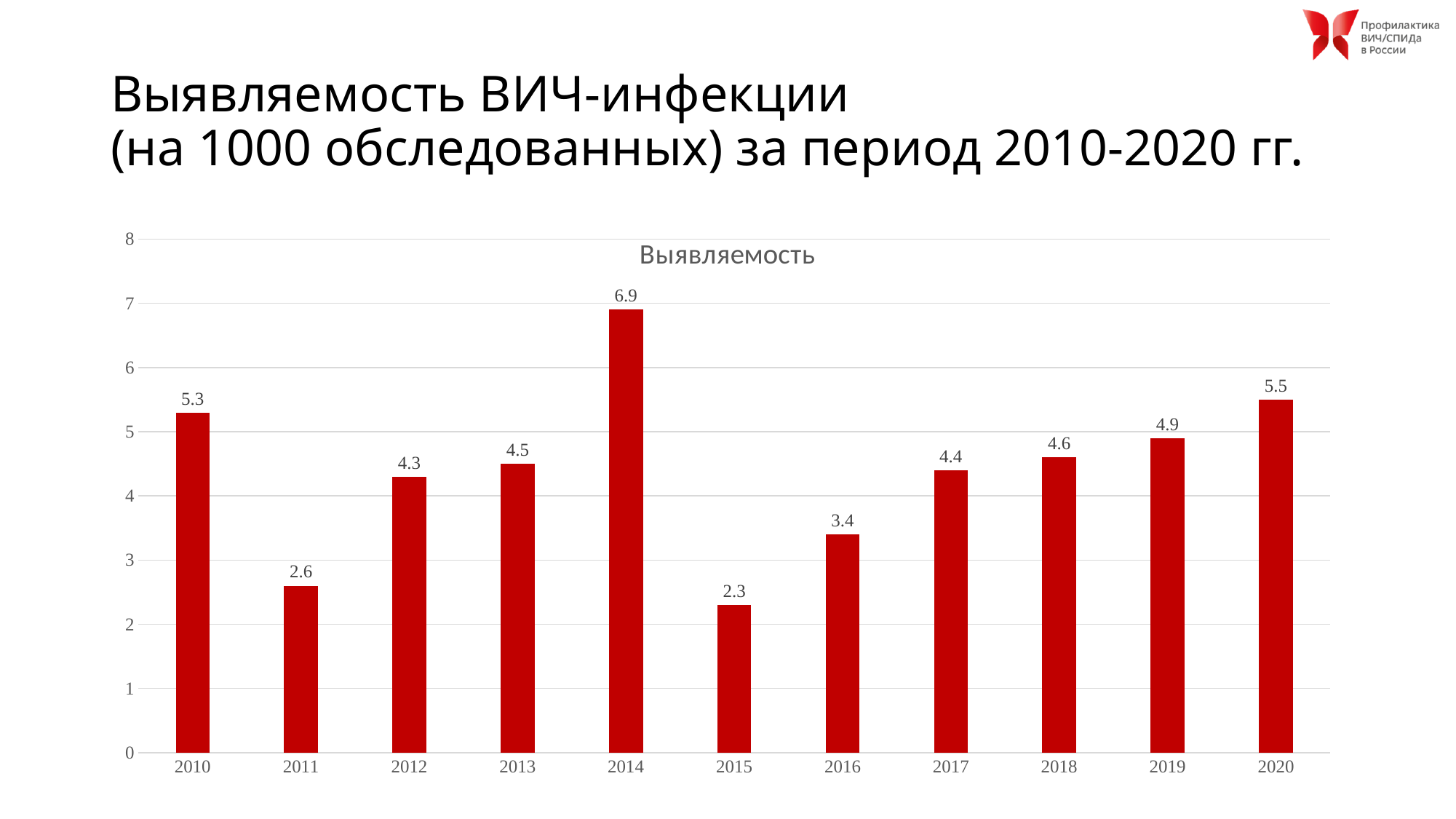
What is the value for 2011? 2.6 Which year has the lowest value? 2015 What is the difference between the values for 2014 and 2015? 4.6 Is the value for 2016 greater or less than 4? less How many years are shown on the x axis? 11 What kind of chart is this? bar chart Which year has the highest value? 2014 What is the value for 2014? 6.9 Which is larger, the value for 2010 or the value for 2019? 2010 What is the title shown inside the chart area? Выявляемость What is the value for 2020? 5.5 Do the values rise or fall from 2015 to 2020? rise